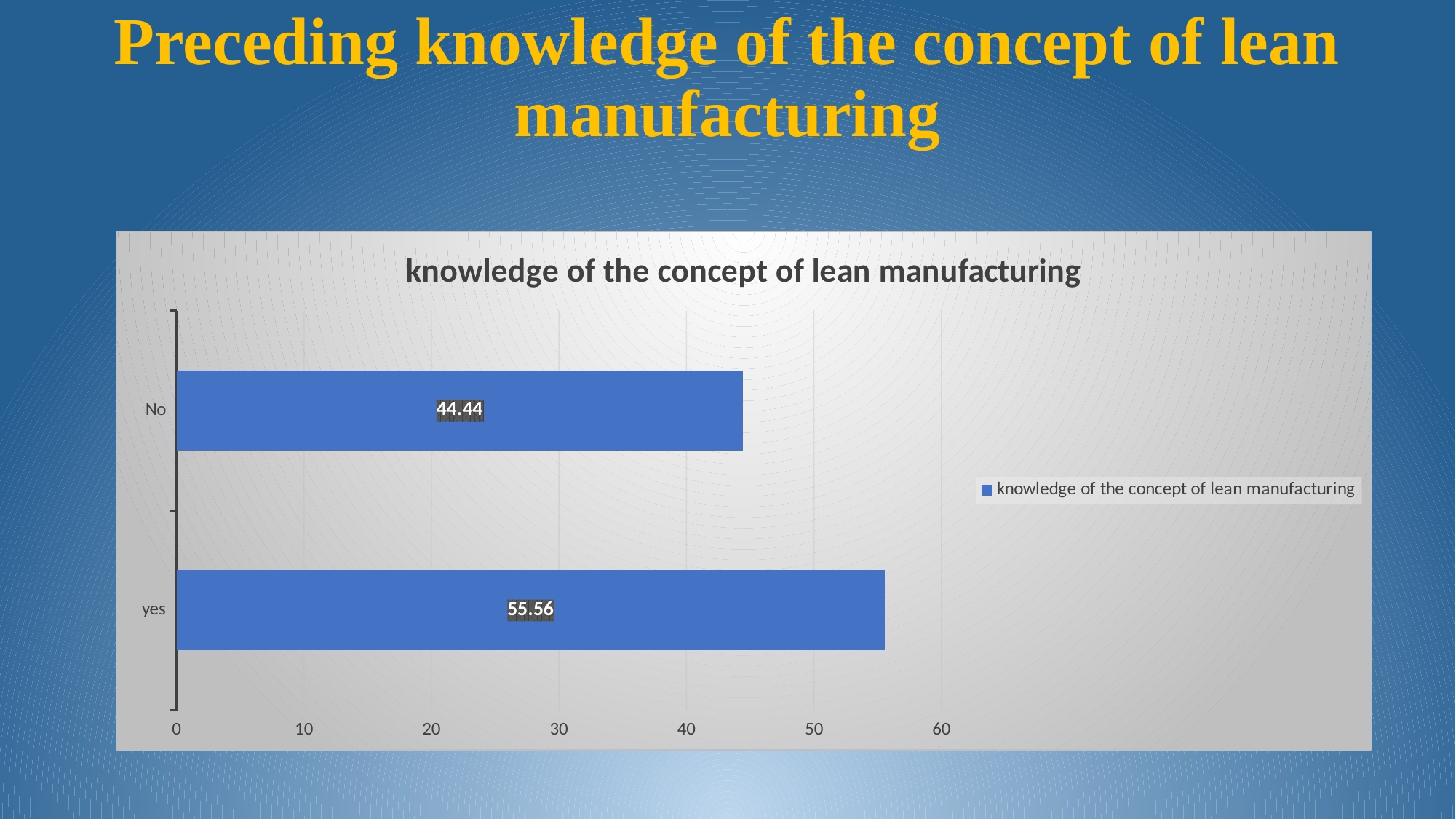
What is the title of the chart? knowledge of the concept of lean manufacturing Which category has the lowest value? No Is the value for "No" greater or less than 50? less How many categories are shown in the chart? 2 What kind of chart is shown on the slide? bar chart Is the value for "yes" greater or less than 50? greater What is the value for "No"? 44.44 How many series does the legend list? 1 What is the value for "yes"? 55.56 Which category has the highest value? yes Which is larger, the value for "yes" or the value for "No"? yes What is the difference between the values for "yes" and "No"? 11.12